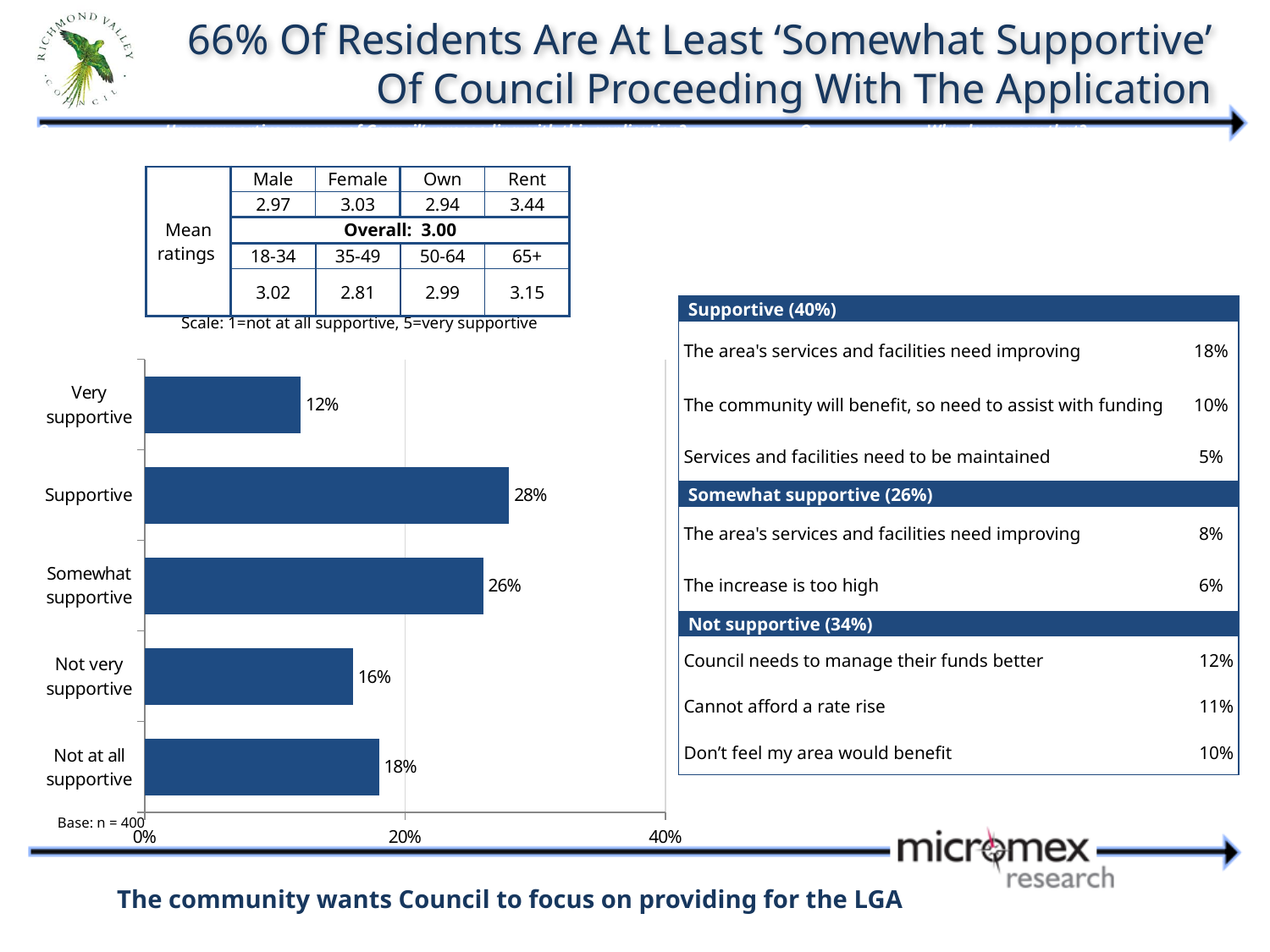
Which category has the highest percentage in the bar chart? Supportive What is the combined percentage of 'Not very supportive' and 'Not at all supportive'? 34% What percentage of residents are 'Supportive'? 28% What percentage of residents are 'Very supportive'? 12% Which category has the lowest percentage in the bar chart? Very supportive What percentage of residents are 'Not at all supportive'? 18% Which is larger, the percentage for 'Not very supportive' or 'Not at all supportive'? Not at all supportive What is the base sample size noted below the bar chart? n = 400 How many categories are shown in the bar chart? 5 What is the difference in percentage points between 'Supportive' and 'Somewhat supportive'? 2% What kind of chart is used to show the support levels? Bar chart Is the value for 'Somewhat supportive' greater or less than 20%? greater